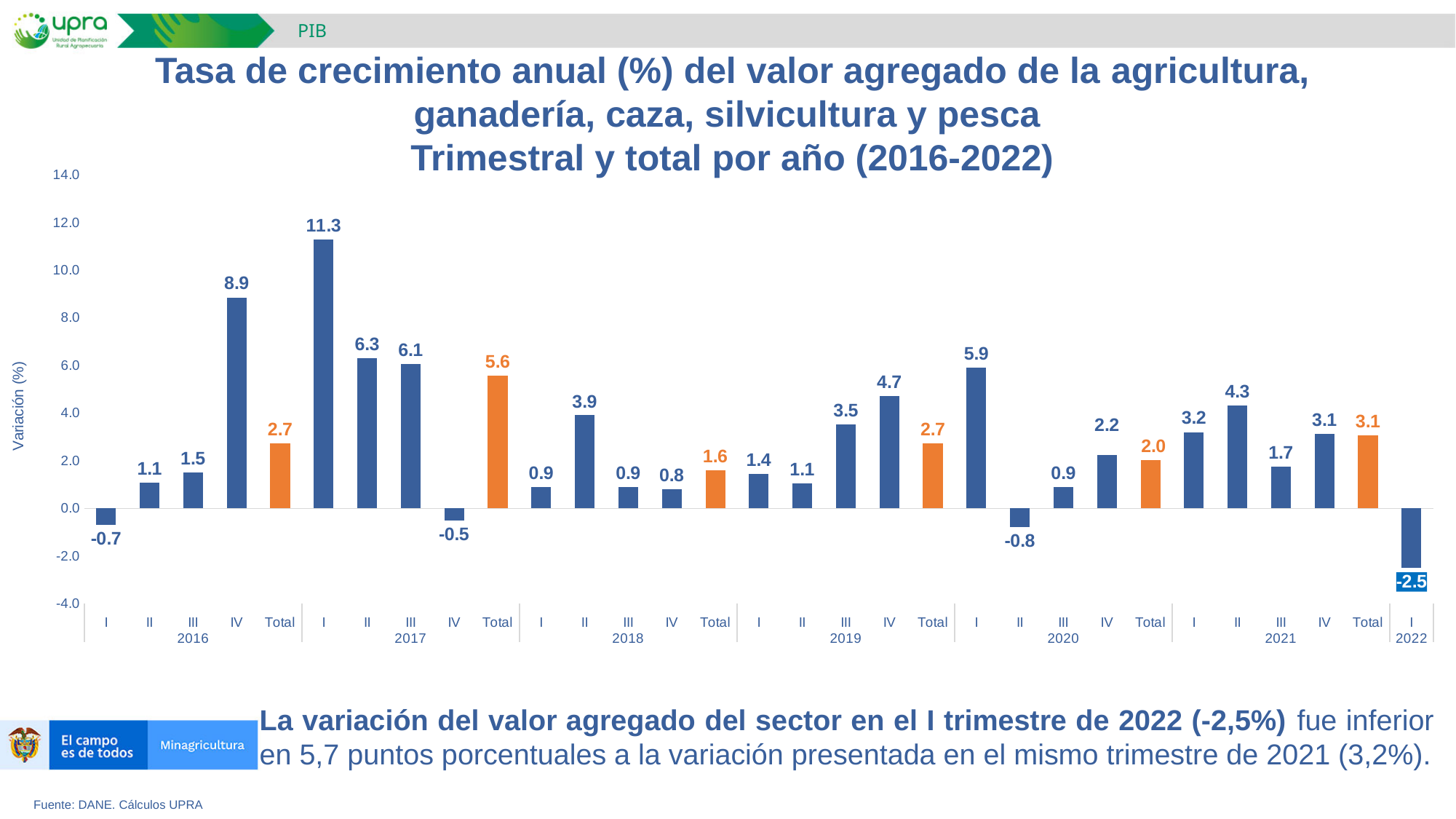
What is the difference between the value for quarter I of 2021 and quarter I of 2022? 5.7 What type of chart is shown on the slide? Bar chart Which bar has the lowest value in the chart? I 2022 How many bars are plotted in the chart? 31 What is the annual total value for 2018? 1.6 What is the value for quarter IV of 2019? 4.7 What is the value for quarter I of 2017? 11.3 What colour are the annual total bars? Orange What is the value for quarter I of 2022? -2.5 Which annual total is higher, 2019 or 2020? 2019 Which bar has the highest value in the chart? I 2017 Which is larger, the annual total for 2017 or the annual total for 2021? Total 2017